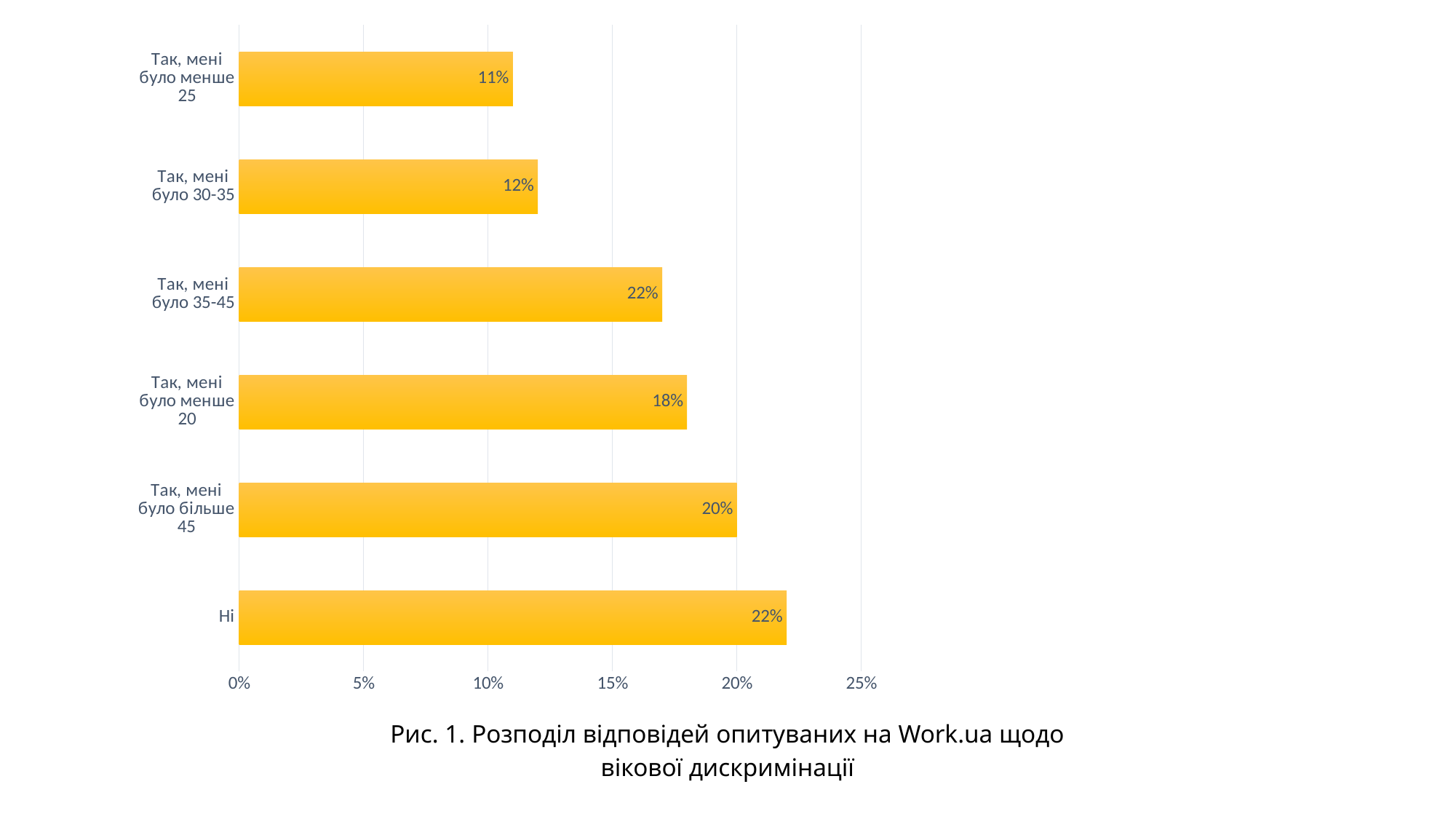
What is the value for "Ні"? 22% What is the value for "Так, мені було менше 20"? 18% What kind of chart is shown on the slide? bar chart What is the value for "Так, мені було менше 25"? 11% Which category has the lowest value? Так, мені було менше 25 What is the value for "Так, мені було більше 45"? 20% How many categories are shown in the chart? 6 What is the caption of the chart? Рис. 1. Розподіл відповідей опитуваних на Work.ua щодо вікової дискримінації Is the value for "Ні" greater or less than 20%? greater What is the value for "Так, мені було 30-35"? 12% Which is larger: the value for "Так, мені було більше 45" or for "Так, мені було менше 20"? Так, мені було більше 45 What is the difference between the values for "Так, мені було менше 20" and "Так, мені було 30-35"? 6%